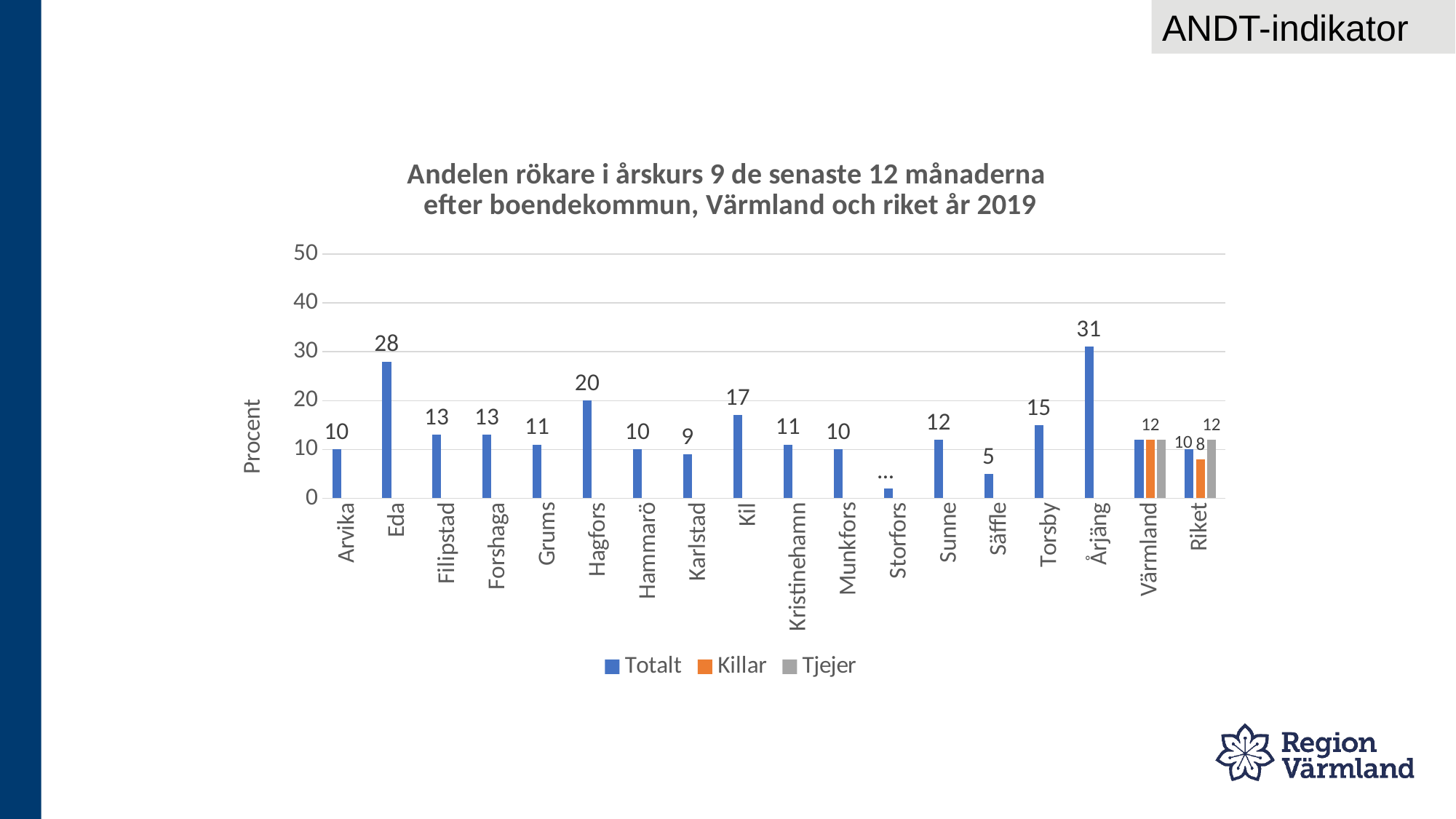
Among the municipalities with a printed value, which has the lowest Totalt value? Säffle What is the difference between the Totalt values for Årjäng and Eda? 3 For Riket, what is the difference between the Tjejer and Killar values? 4 Which municipality has the highest Totalt value? Årjäng How many series does the legend list? 3 Which has a higher Totalt value, Hagfors or Kil? Hagfors What is the Totalt value for Eda? 28 What is the Totalt value for Torsby? 15 Is the Totalt value for Storfors greater or less than 10? less What is the Killar value for Riket? 8 What is the Tjejer value for Riket? 12 How many categories are shown on the x axis? 18